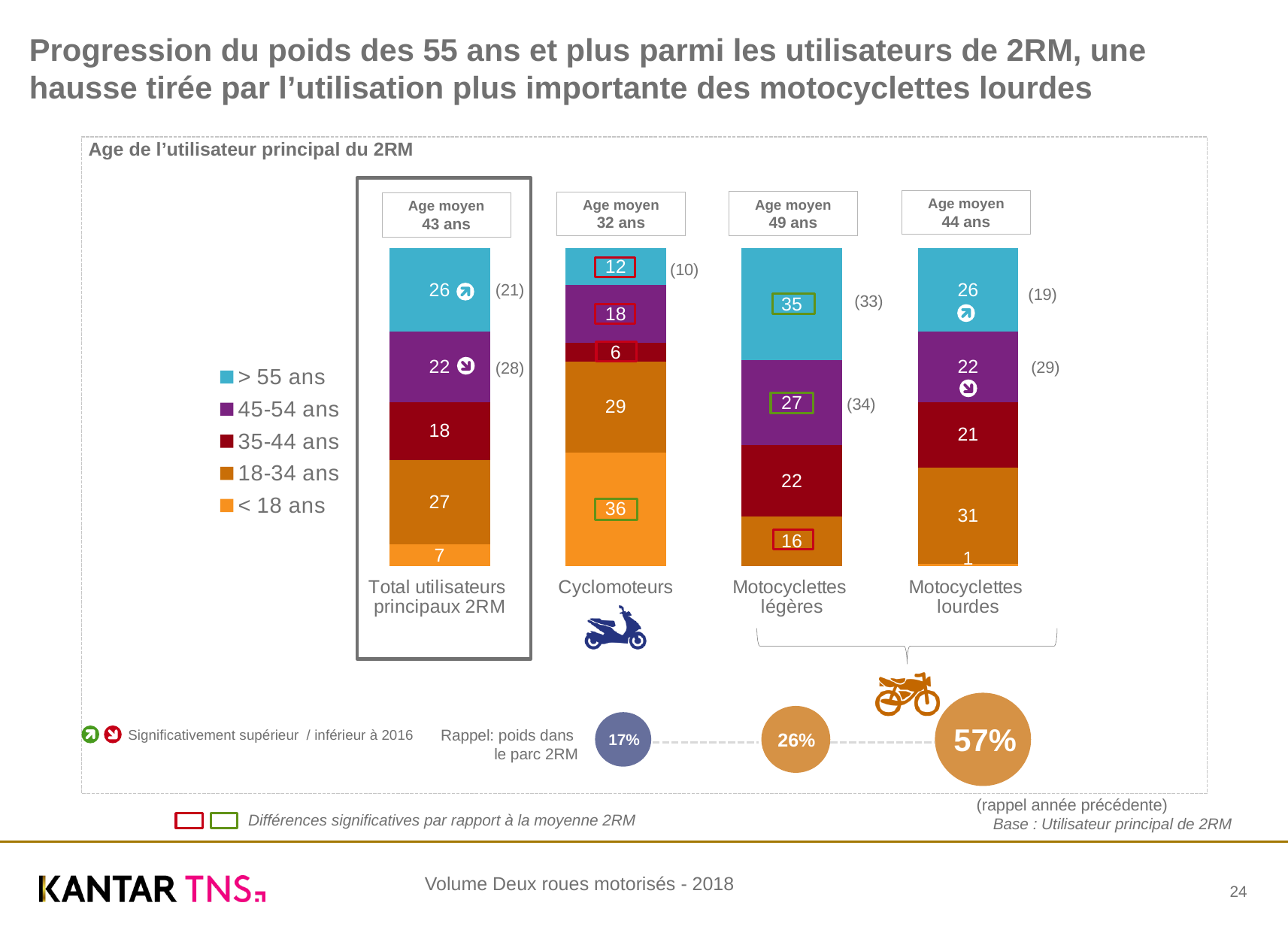
Which category has the lowest 35-44 ans value? Cyclomoteurs What is the value of the 18-34 ans segment for Motocyclettes lourdes? 31 What is the difference between the 18-34 ans values for Motocyclettes lourdes and Motocyclettes légères? 15 How many categories (bars) are plotted in the chart? 4 What is the value of the 35-44 ans segment for Total utilisateurs principaux 2RM? 18 What kind of chart is shown on the slide? stacked bar chart How many series does the legend list? 5 Which is larger: the 45-54 ans value for Motocyclettes légères or for Cyclomoteurs? Motocyclettes légères What is the average age (Age moyen) shown above the Motocyclettes légères bar? 49 ans What is the value of the > 55 ans segment for Motocyclettes légères? 35 Which category has the highest > 55 ans value? Motocyclettes légères What is the value of the < 18 ans segment for Cyclomoteurs? 36